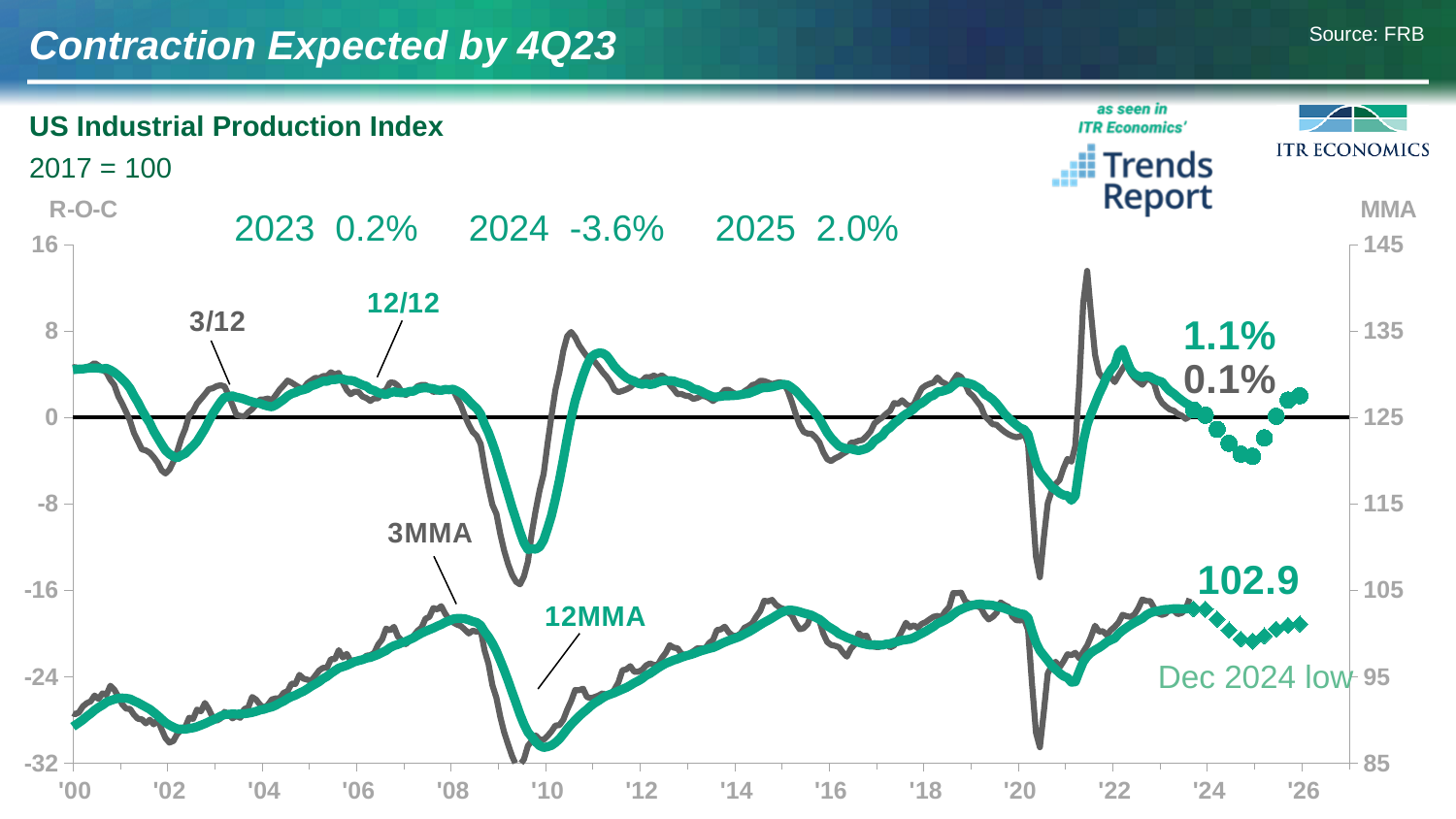
What is the title of the chart? US Industrial Production Index What is the forecast rate for 2024 shown above the chart? -3.6% What kind of chart is shown on the slide? line chart Is the 12/12 rate-of-change value at its 2009 trough greater or less than -8? less Which of the three annual forecasts (2023, 2024, 2025) is the lowest? 2024 What is the forecast rate for 2025 shown above the chart? 2.0% What is the difference between the 2025 forecast and the 2024 forecast? 5.6 percentage points What is the 12MMA value labeled on the chart? 102.9 What is the latest 12/12 rate-of-change value labeled on the chart? 1.1% How many data series are labeled on the chart? 4 What is the latest 3/12 rate-of-change value labeled on the chart? 0.1% What is the forecast rate for 2023 shown above the chart? 0.2%